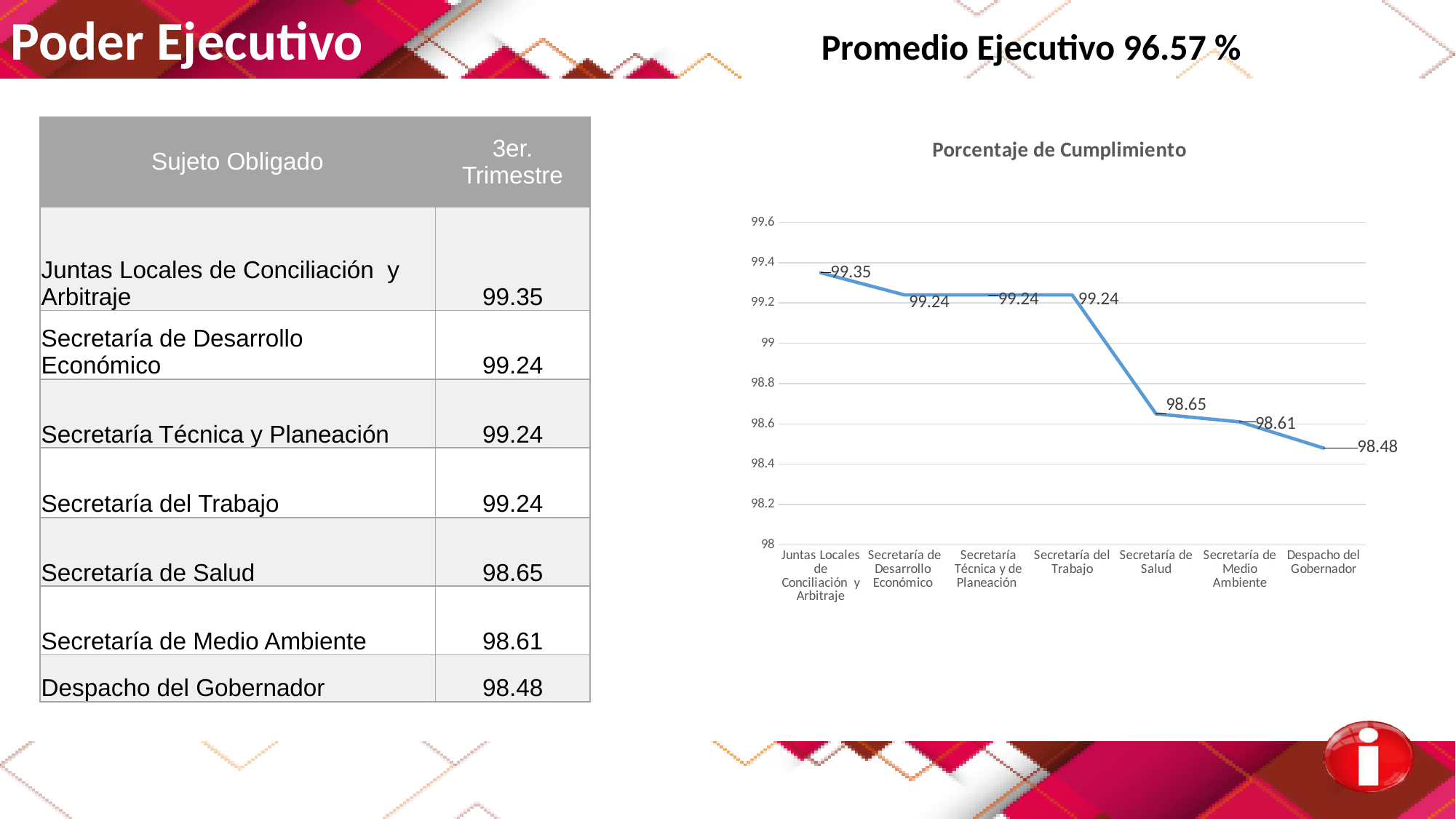
What is the value for Juntas Locales de Conciliación y Arbitraje in the chart? 99.35 Which category has the lowest value in the chart? Despacho del Gobernador What is the value for Despacho del Gobernador in the chart? 98.48 What kind of chart is shown on the slide? line chart Which category has the highest value in the chart? Juntas Locales de Conciliación y Arbitraje Which is larger, the value for Secretaría de Salud or the value for Secretaría de Medio Ambiente? Secretaría de Salud How many categories are plotted in the chart? 7 What is the difference between the values for Juntas Locales de Conciliación y Arbitraje and Despacho del Gobernador? 0.87 Do the values rise or fall from left to right along the x axis? fall What is the value for Secretaría de Salud in the chart? 98.65 Is the value for Secretaría del Trabajo greater or less than 99? greater What is the title of the chart? Porcentaje de Cumplimiento